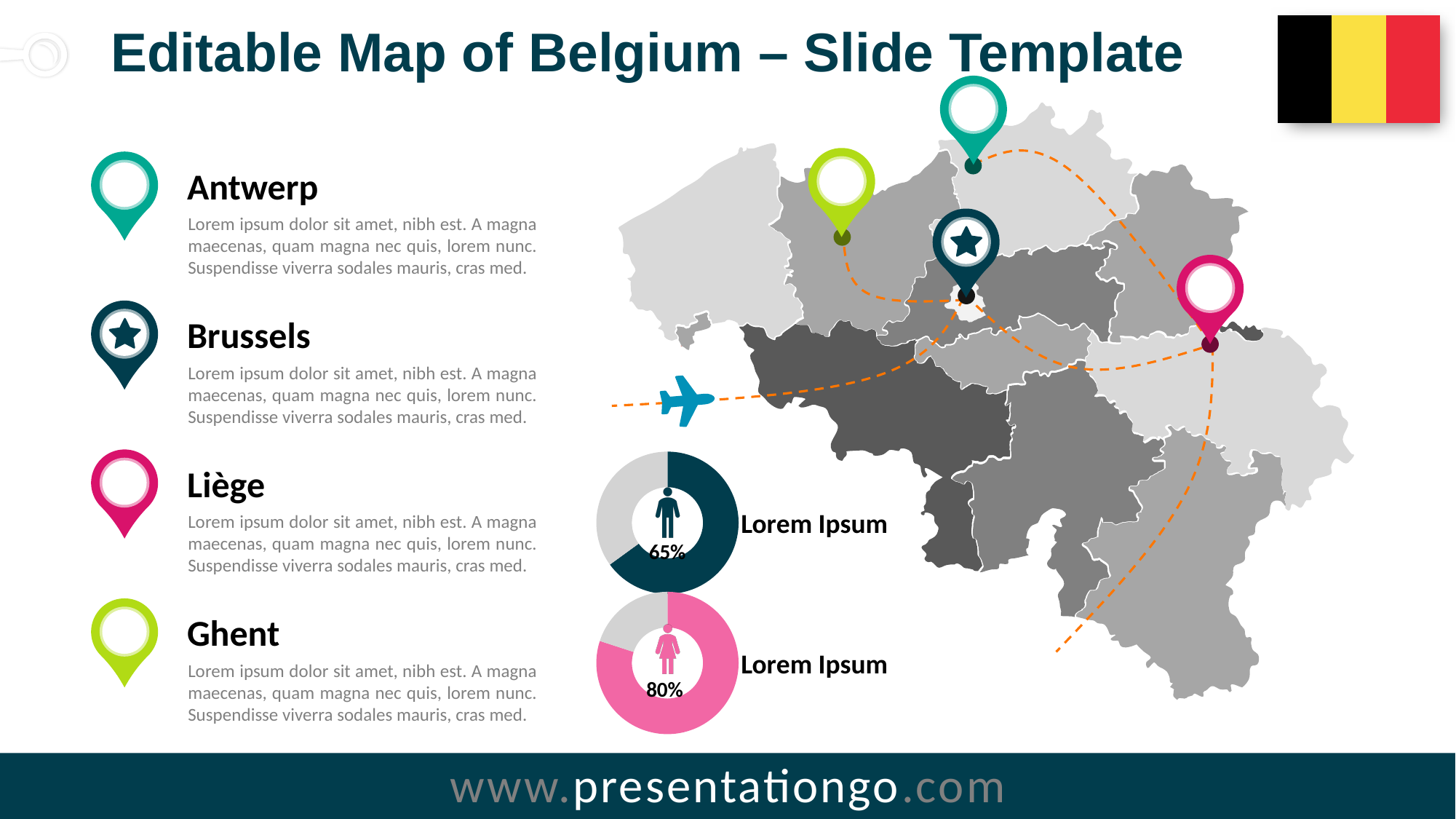
What is the difference between the percentage in the lower donut chart and the percentage in the upper donut chart? 15 percentage points Is the value shown in the upper donut chart greater or less than 50%? greater What colour is the filled portion of the lower donut chart? pink What percentage is shown in the upper donut chart (with the male figure icon)? 65% What label text appears to the right of each donut chart? Lorem Ipsum What kind of chart is used to display the 65% and 80% values on the slide? donut chart Which of the two donut charts shows the larger percentage, the upper one or the lower one? the lower one (80%) What percentage is shown in the lower donut chart (with the female figure icon)? 80% How many donut charts are on the slide? 2 What share of the upper donut chart is left unfilled (grey)? 35% What share of the lower donut chart is left unfilled (grey)? 20%